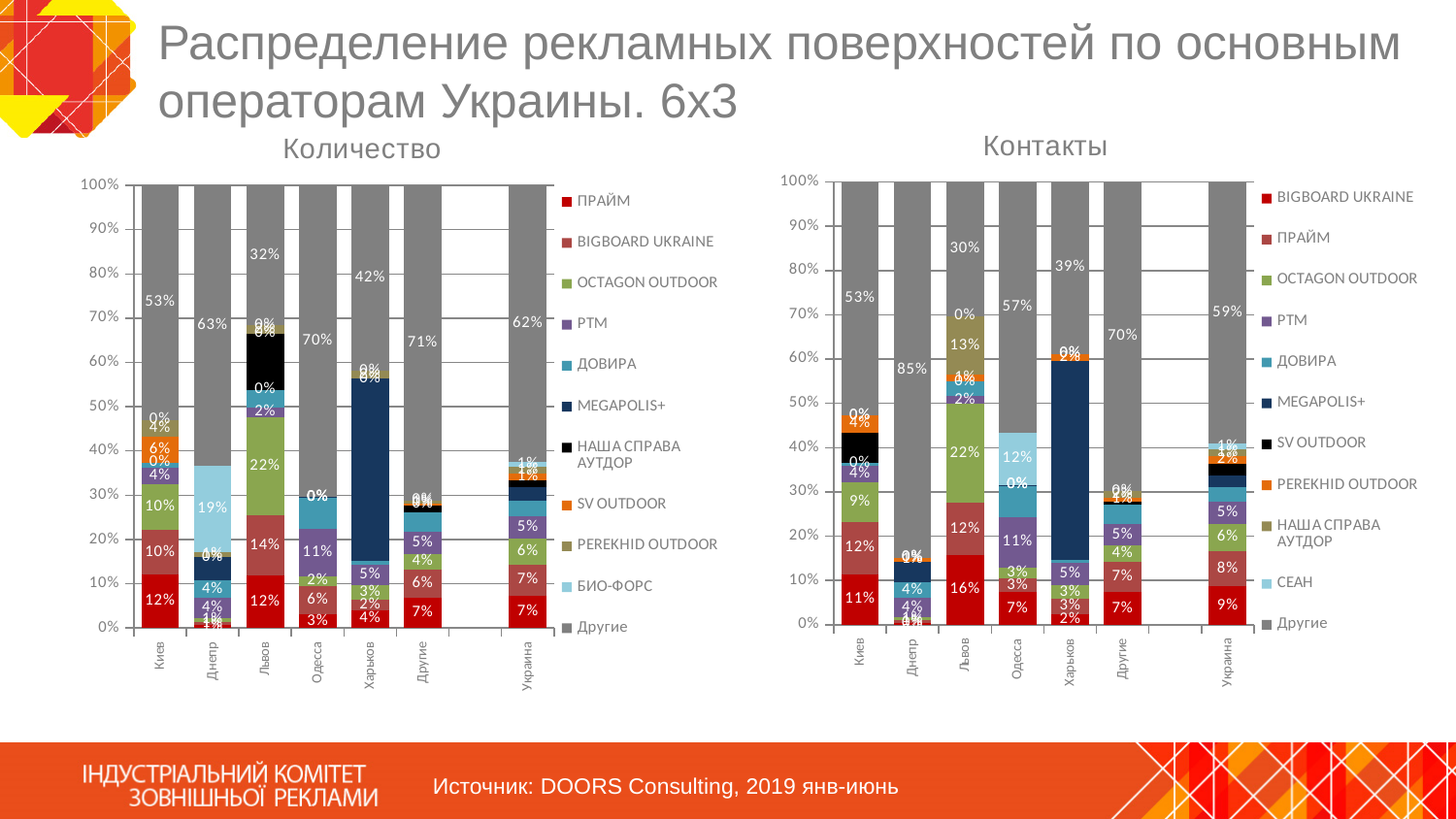
In the "Контакты" chart, which city has the largest "Другие" segment? Днепр In the "Контакты" chart, what is the value of the "СЕАН" segment for Одесса? 12% In the "Количество" chart, what is the difference between the "Другие" segments for Одесса (70%) and Харьков (42%)? 28% In the "Количество" chart, which category has the smallest "Другие" segment? Львов In the "Контакты" chart, what is the value of the "Другие" segment for Днепр? 85% In the "Количество" chart, what is the value of the "БИО-ФОРС" segment for Днепр? 19% In the "Контакты" chart, what is the value of the "OCTAGON OUTDOOR" segment for Львов? 22% In the "Количество" chart, what is the value of the "Другие" segment for Киев? 53% What kind of chart is the "Количество" chart? Stacked bar chart In the "Контакты" chart, which is larger for Украина: the "BIGBOARD UKRAINE" segment or the "ПРАЙМ" segment? BIGBOARD UKRAINE How many series does the legend of the "Количество" chart list? 11 How many categories are shown on the x axis of the "Контакты" chart? 7